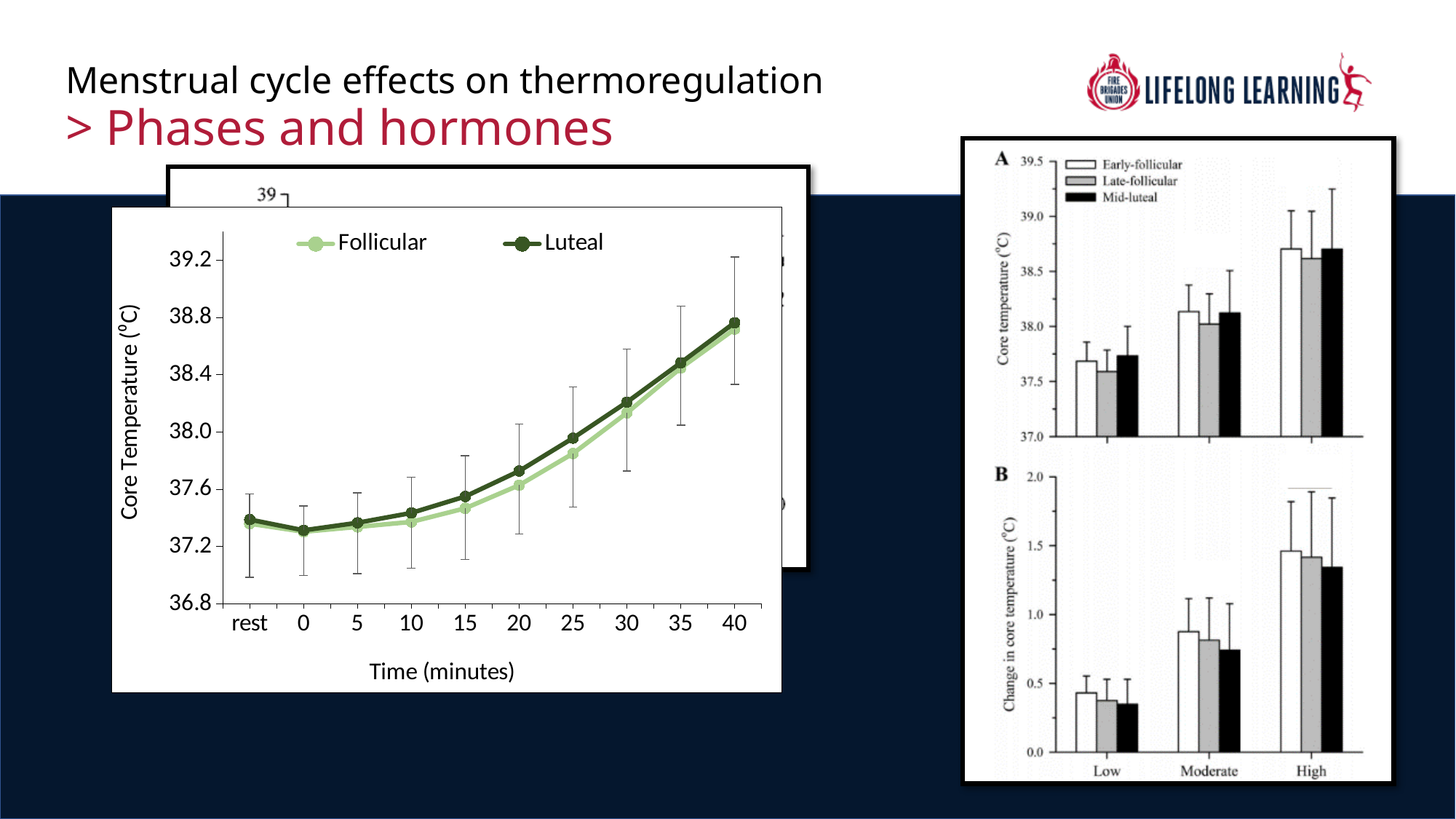
What kind of chart is the right-hand figure with panels A and B? bar chart In the left line chart, is the Follicular value at rest greater or less than 37.6? less In panel B of the right-hand chart, is the Early-follicular value for High greater or less than 1.0? greater In the left line chart, at 25 minutes, which series has the higher core temperature, Follicular or Luteal? Luteal In the left line chart, do the core temperature values rise or fall from rest to 40 minutes? rise What kind of chart is the left chart showing core temperature against time? line chart How many time points are plotted along the x axis of the left line chart? 10 In the left line chart, is the Follicular value at 30 minutes greater or less than 38.0? greater How many series does the legend of the left line chart list? 2 How many series does the legend in panel A of the right-hand chart list? 3 In the left line chart, at which time point does the Luteal series reach its highest value? 40